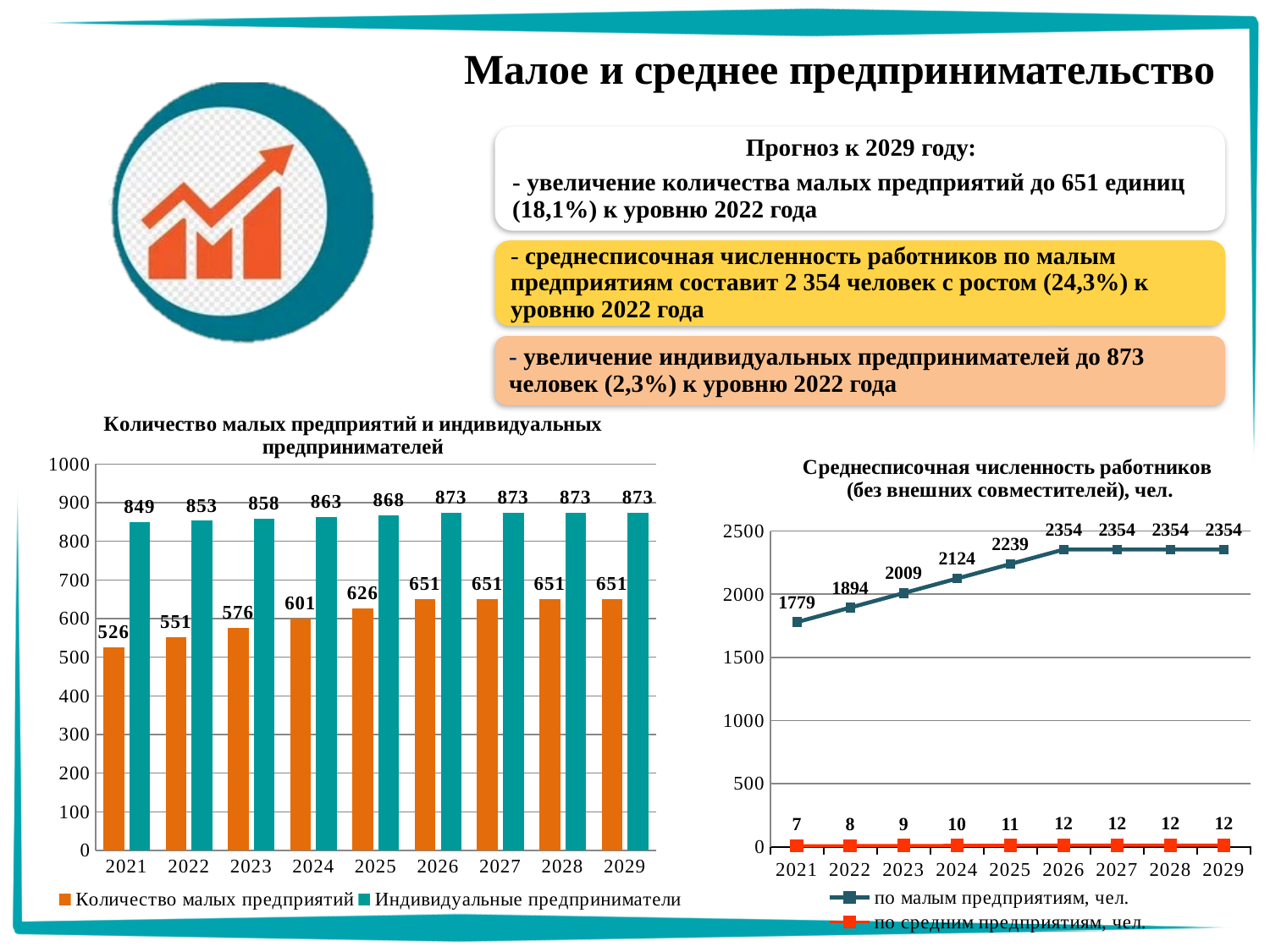
What kind of chart is 'Среднесписочная численность работников (без внешних совместителей), чел.'? line chart In the chart 'Среднесписочная численность работников (без внешних совместителей), чел.', what is the difference between the 'по малым предприятиям, чел.' values in 2029 and 2021? 575 In the chart 'Среднесписочная численность работников (без внешних совместителей), чел.', does the value for 'по малым предприятиям, чел.' rise or fall from 2021 to 2026? rise In the chart 'Количество малых предприятий и индивидуальных предпринимателей', what is the value for 'Индивидуальные предприниматели' in 2024? 863 In the chart 'Количество малых предприятий и индивидуальных предпринимателей', what is the value for 'Количество малых предприятий' in 2021? 526 In the chart 'Количество малых предприятий и индивидуальных предпринимателей', what is the difference between 'Индивидуальные предприниматели' and 'Количество малых предприятий' in 2022? 302 In the chart 'Количество малых предприятий и индивидуальных предпринимателей', which year has the lowest value for 'Количество малых предприятий'? 2021 In the chart 'Среднесписочная численность работников (без внешних совместителей), чел.', what is the value for 'по малым предприятиям, чел.' in 2023? 2009 In the chart 'Количество малых предприятий и индивидуальных предпринимателей', how many years are shown on the x axis? 9 In the chart 'Среднесписочная численность работников (без внешних совместителей), чел.', what is the value for 'по средним предприятиям, чел.' in 2025? 11 What kind of chart is 'Количество малых предприятий и индивидуальных предпринимателей'? bar chart In the chart 'Количество малых предприятий и индивидуальных предпринимателей', how many series does the legend list? 2